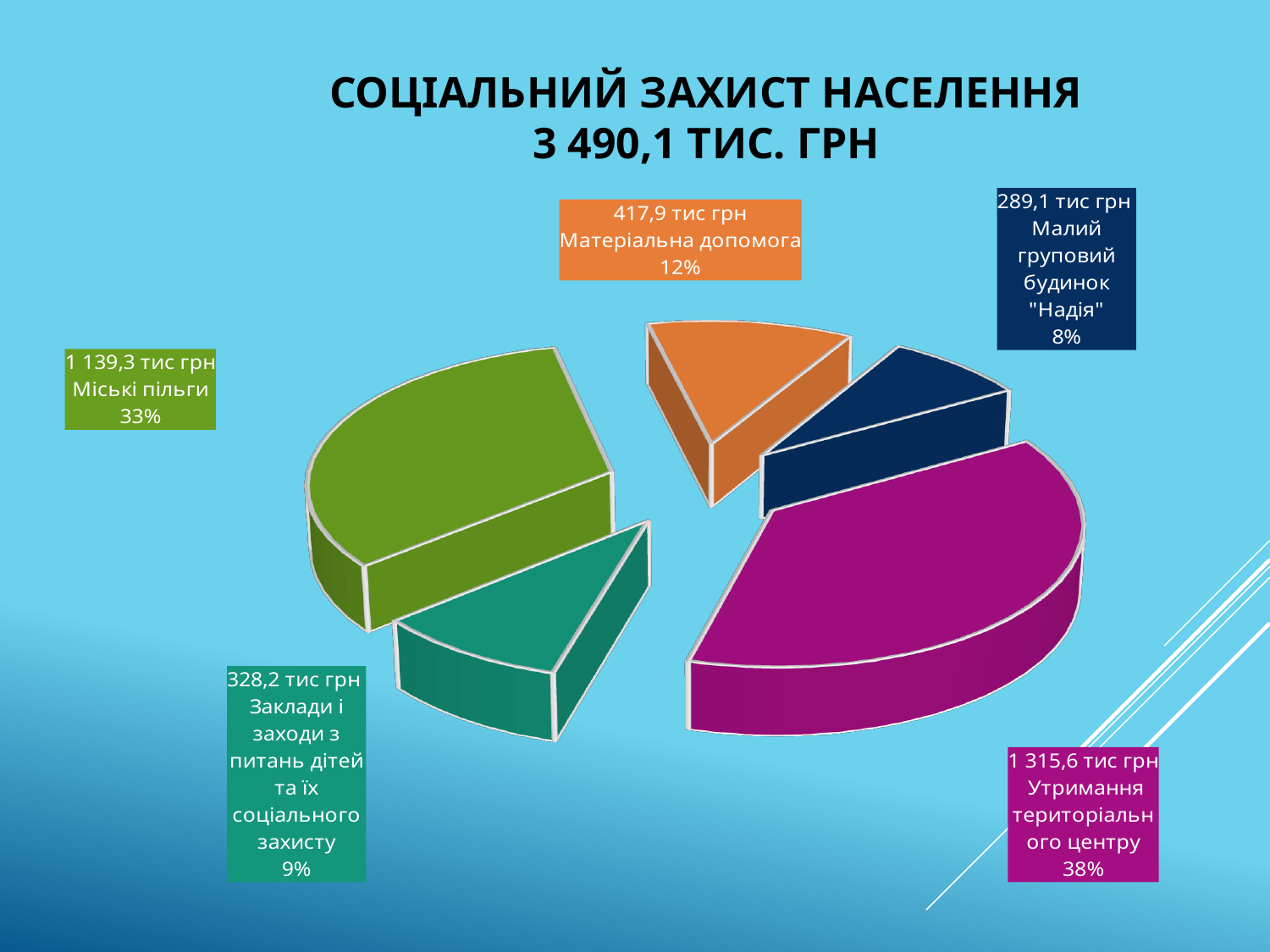
What is the difference between the values for Утримання територіального центру and Міські пільги? 176,3 тис грн What kind of chart is shown on the slide? pie chart Which category has the largest value? Утримання територіального центру What is the value for Міські пільги? 1 139,3 тис грн Which category has the smallest value? Малий груповий будинок "Надія" What is the value for Матеріальна допомога? 417,9 тис грн What share of the pie does Заклади і заходи з питань дітей та їх соціального захисту represent? 9% What share of the pie does Утримання територіального центру represent? 38% What is the value for Малий груповий будинок "Надія"? 289,1 тис грн Which is larger: Матеріальна допомога or Заклади і заходи з питань дітей та їх соціального захисту? Матеріальна допомога What total amount is stated in the chart title? 3 490,1 тис. грн How many slices does the pie chart have? 5